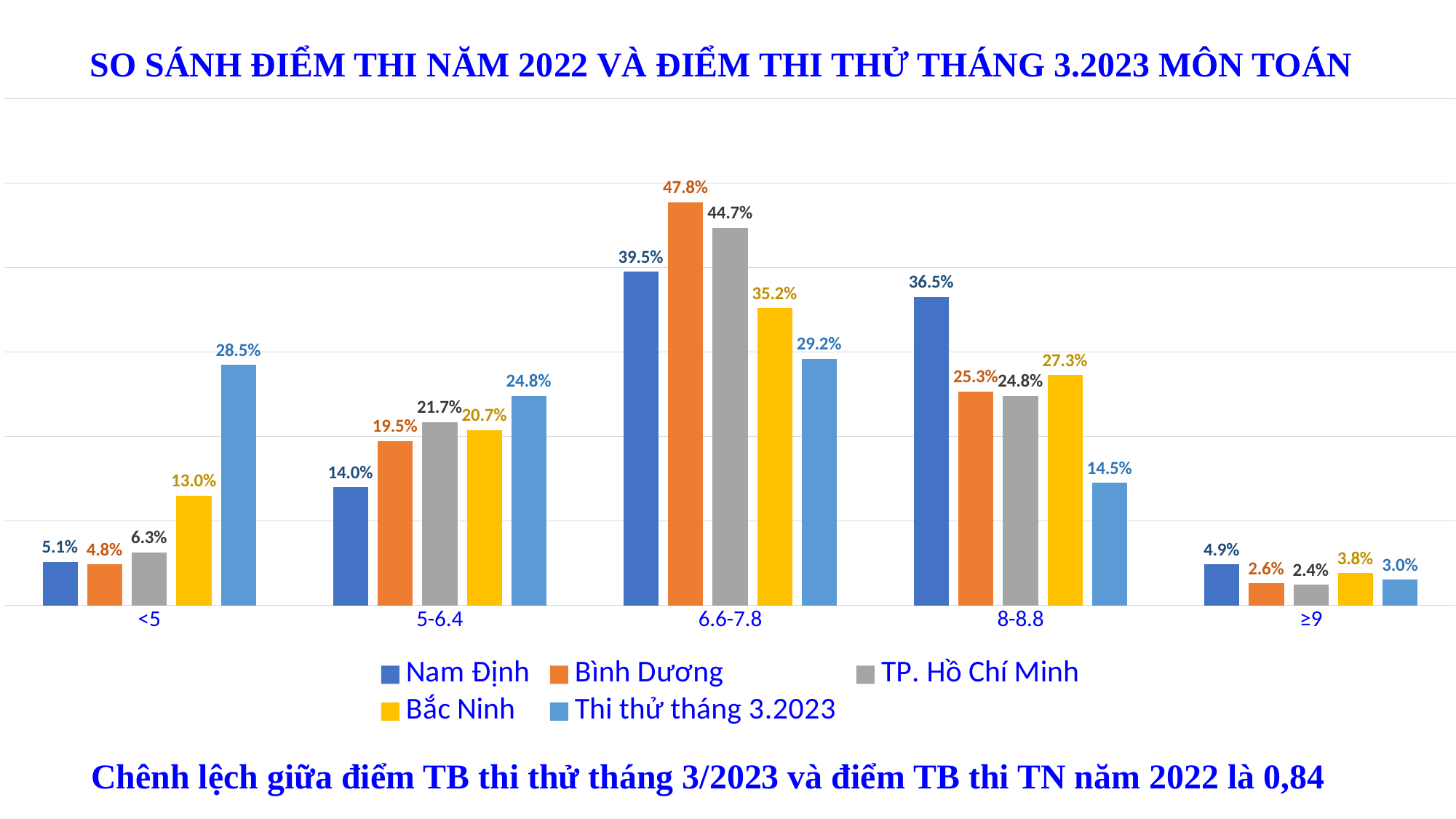
Which series has the lowest value in the ≥9 category? TP. Hồ Chí Minh What is the title of the chart? SO SÁNH ĐIỂM THI NĂM 2022 VÀ ĐIỂM THI THỬ THÁNG 3.2023 MÔN TOÁN Which is larger in the 5-6.4 category: TP. Hồ Chí Minh or Bắc Ninh? TP. Hồ Chí Minh What is the value for Bình Dương in the 6.6-7.8 category? 47.8% What is the value for Thi thử tháng 3.2023 in the <5 category? 28.5% Which category has the highest value for Nam Định? 6.6-7.8 What kind of chart is shown on the slide? bar chart How many series does the legend list? 5 What is the value for Bắc Ninh in the 8-8.8 category? 27.3% What is the difference between Nam Định and Thi thử tháng 3.2023 in the 8-8.8 category? 22.0% How many score categories are shown on the x axis? 5 Which series has the highest value in the 6.6-7.8 category? Bình Dương